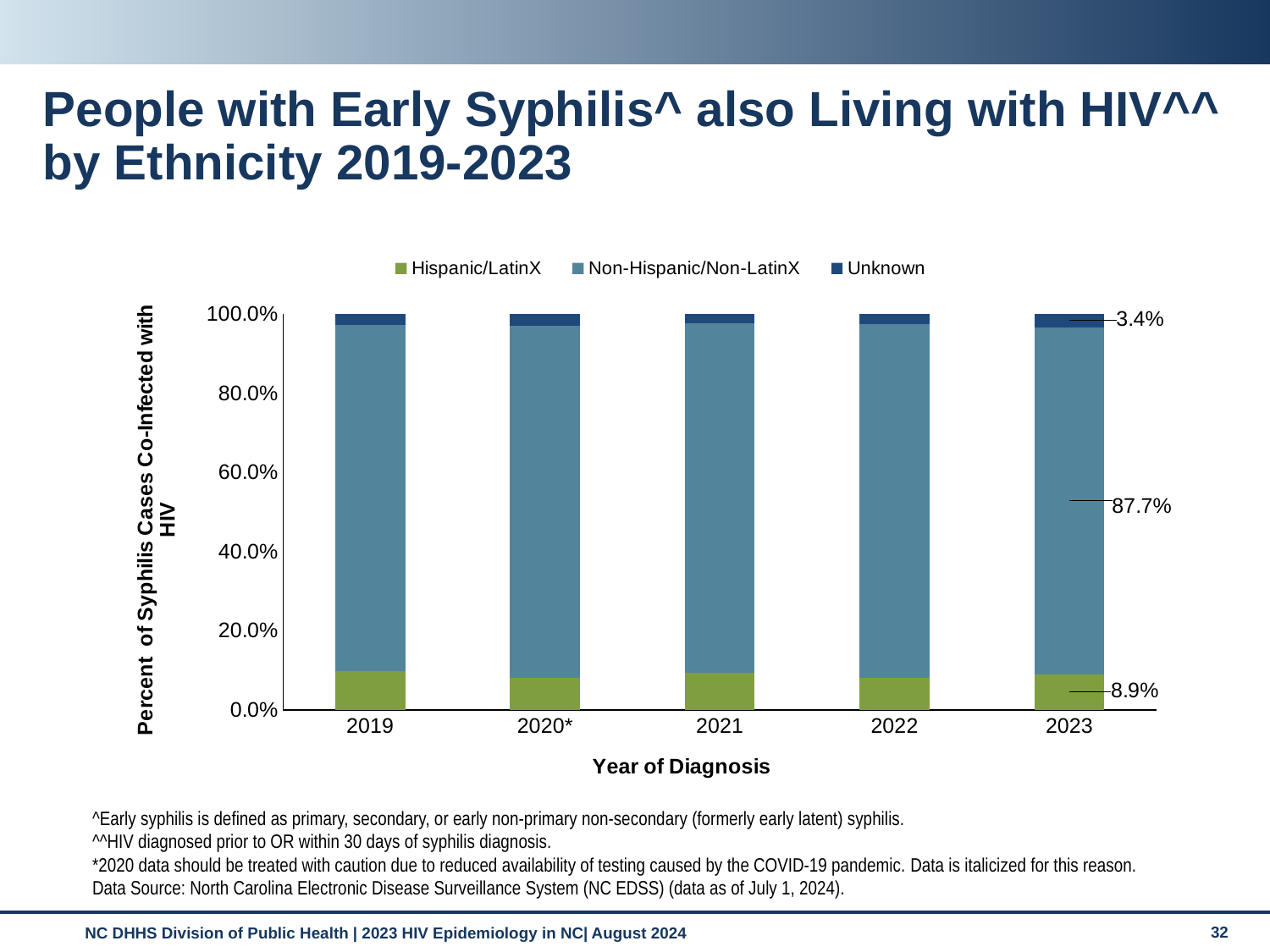
What percentage of the 2023 bar is Unknown? 3.4% In 2023, which ethnicity group has the smallest share of the bar? Unknown What percentage of the 2023 bar is Hispanic/LatinX? 8.9% How many years are shown on the x axis? 5 Is the Non-Hispanic/Non-LatinX share in 2021 greater or less than 80.0%? greater How many series does the legend list? 3 What is the title of the x axis? Year of Diagnosis What kind of chart is shown on the slide? Stacked bar chart In 2023, which ethnicity group has the largest share of the bar? Non-Hispanic/Non-LatinX What is the difference between the Non-Hispanic/Non-LatinX and Hispanic/LatinX percentages in 2023? 78.8 percentage points Is the Hispanic/LatinX share in 2019 greater or less than 20.0%? less What percentage of the 2023 bar is Non-Hispanic/Non-LatinX? 87.7%